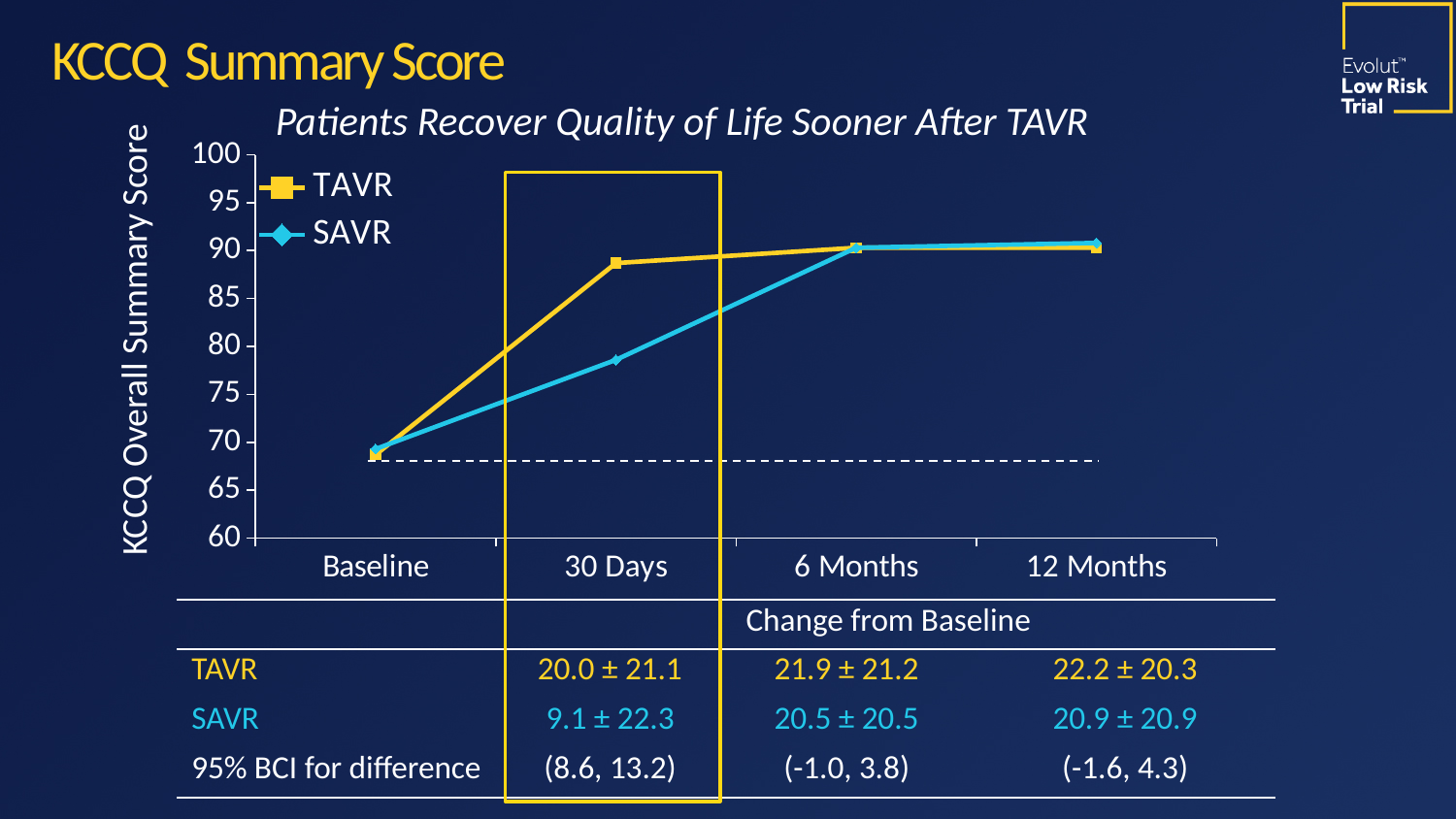
Is the SAVR value at 30 Days greater or less than 80? less Is the TAVR value at Baseline greater or less than 70? less At which time point is the SAVR score lowest? Baseline How many series does the chart legend list? 2 At 30 Days, which series has the higher KCCQ Overall Summary Score, TAVR or SAVR? TAVR How many time points are plotted along the x axis of the chart? 4 In the table below the chart, what is the TAVR change from baseline at 30 Days? 20.0 ± 21.1 What kind of chart is shown on the slide? line chart Is the TAVR value at 30 Days greater or less than 85? greater What is the title of the y axis of the chart? KCCQ Overall Summary Score Does the TAVR score rise or fall from Baseline to 6 Months? rise Which series is plotted in yellow in the chart? TAVR